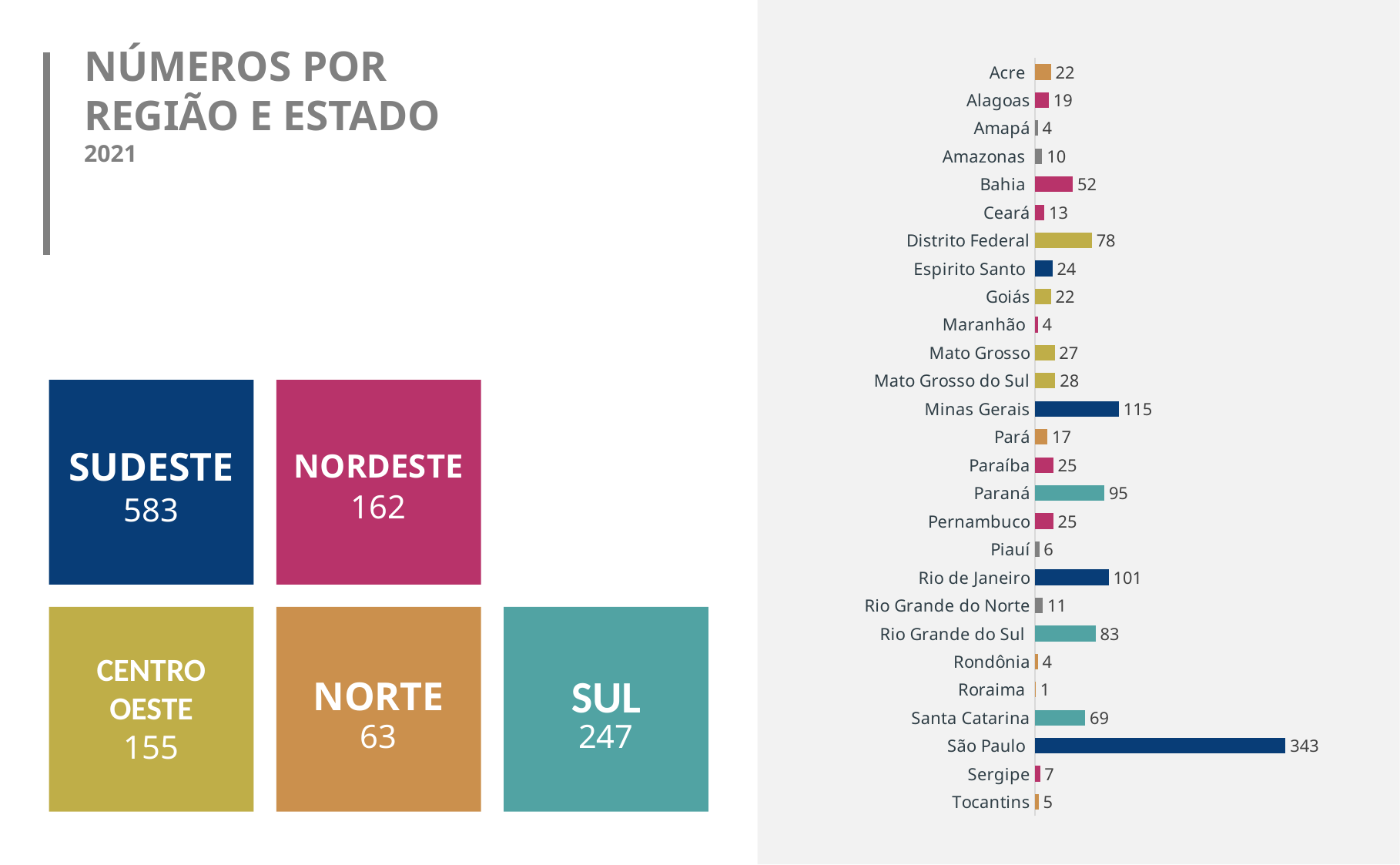
What is the value for São Paulo in the bar chart? 343 What is the difference between the values for Minas Gerais and Rio de Janeiro in the bar chart? 14 Which has a larger value in the bar chart, Mato Grosso do Sul or Espirito Santo? Mato Grosso do Sul Which has a larger value in the bar chart, Bahia or Santa Catarina? Santa Catarina Which state has the lowest value in the bar chart? Roraima What is the value for Rio Grande do Sul in the bar chart? 83 What is the value for Distrito Federal in the bar chart? 78 What is the difference between the values for São Paulo and Paraná in the bar chart? 248 What is the title of the slide containing the bar chart? NÚMEROS POR REGIÃO E ESTADO How many states are shown in the bar chart? 27 Which state has the highest value in the bar chart? São Paulo What kind of chart is shown on the right side of the slide? Bar chart